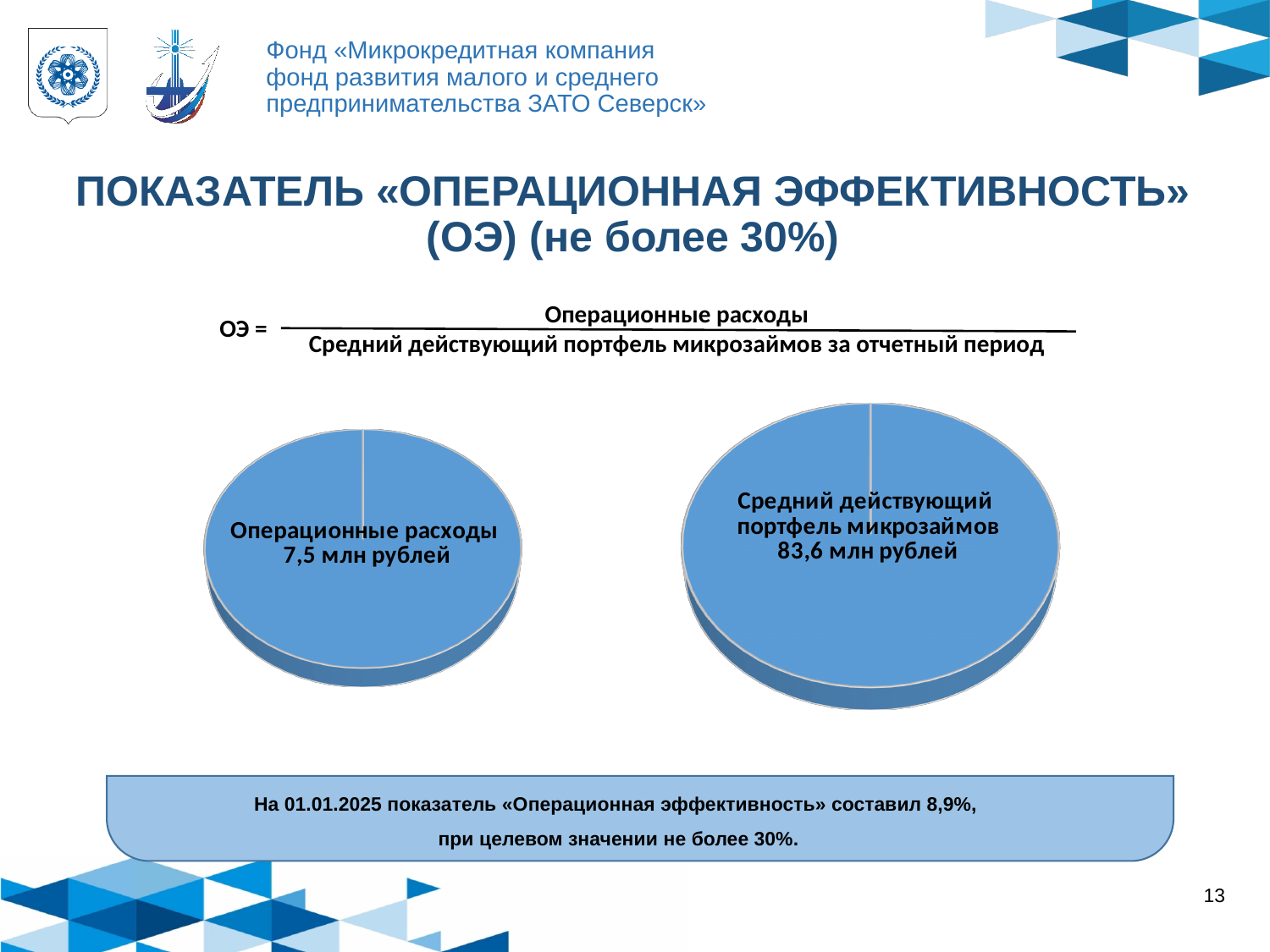
What kind of chart is the left chart labelled Операционные расходы? pie chart What is the difference between the value on the right pie chart (83,6 млн рублей) and the value on the left pie chart (7,5 млн рублей)? 76,1 млн рублей How many slices does the right pie chart (Средний действующий портфель микрозаймов) contain? 1 What colour are the slices in both pie charts? blue Which is larger: the value on the left pie chart (Операционные расходы) or the value on the right pie chart (Средний действующий портфель микрозаймов)? Средний действующий портфель микрозаймов On the left pie chart, what value is shown for Операционные расходы? 7,5 млн рублей How many pie charts are shown on the slide? 2 On the right pie chart, what value is shown for Средний действующий портфель микрозаймов? 83,6 млн рублей What is the label of the single slice on the right pie chart? Средний действующий портфель микрозаймов On the left pie chart, what share of the pie does the Операционные расходы slice take up? 100% What kind of chart is the right chart labelled Средний действующий портфель микрозаймов? pie chart How many slices does the left pie chart (Операционные расходы) contain? 1